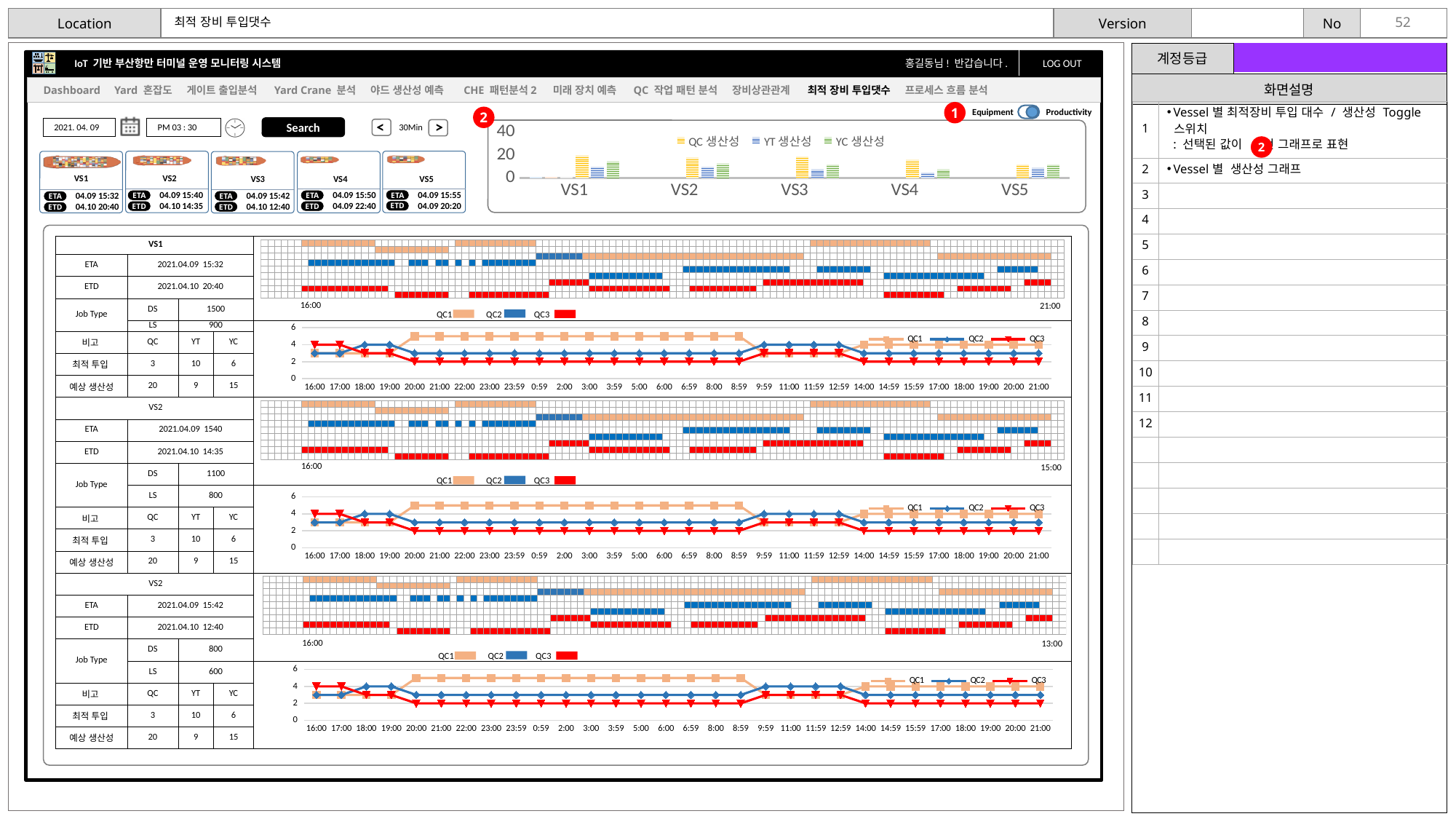
In the top bar chart, which series has the tallest bar for VS1? QC 생산성 How many series does the legend of the top bar chart (QC 생산성 / YT 생산성 / YC 생산성) list? 3 How many series does the legend of the first VS1 line chart list? 3 In the top bar chart, is the QC 생산성 value for VS5 greater or less than 20? less In the first VS1 line chart, is the QC1 value at 22:00 greater or less than 4? greater What kind of chart is the chart at the top of the screen showing QC 생산성, YT 생산성 and YC 생산성 by vessel? bar chart In the top bar chart, which vessel has the lowest QC 생산성 bar? VS5 What kind of chart is the first VS1 chart plotting QC1, QC2 and QC3 over time? line chart How many vessel categories are shown on the x axis of the top bar chart? 5 In the first VS1 line chart, is the QC3 value at 22:00 greater or less than 4? less In the first VS1 line chart, which series is higher at 22:00, QC1 or QC3? QC1